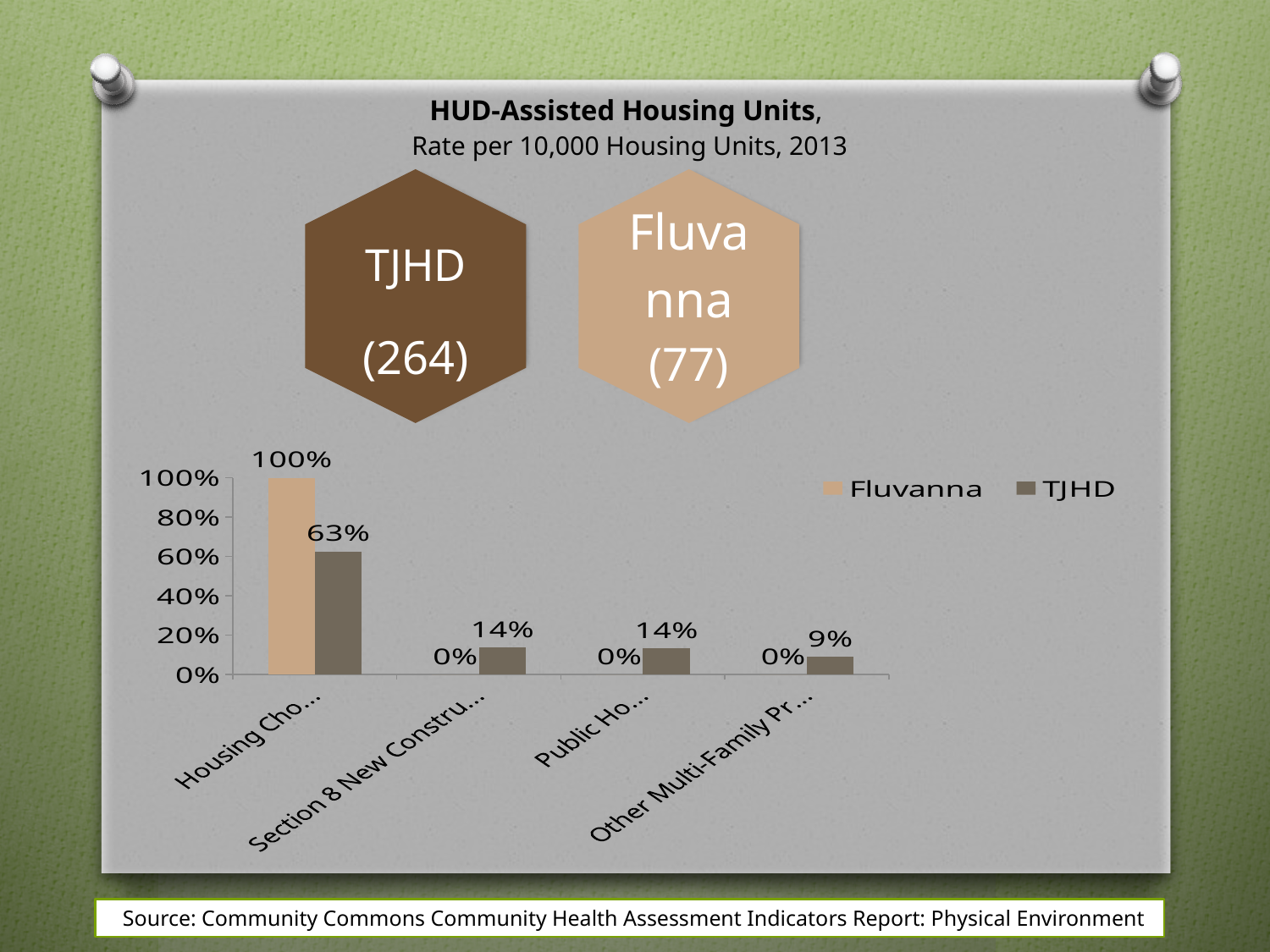
What is the TJHD value for the category labelled Section 8 New Constru...? 14% What is the Fluvanna value for the first category (Housing Cho...)? 100% In the first category (Housing Cho...), what is the difference between the Fluvanna value and the TJHD value? 37% Which category has the lowest TJHD value? Other Multi-Family Pr... (the last category) How many categories are plotted along the x axis of the chart? 4 What is the TJHD value for the first category (Housing Cho...)? 63% How many series does the chart legend list? 2 Which category has the highest TJHD value? Housing Cho... (the first category) What kind of chart is shown on the slide? bar chart What is the TJHD value for the last category (Other Multi-Family Pr...)? 9% What is the Fluvanna value for the category labelled Public Ho...? 0% What are the two entries in the chart legend? Fluvanna and TJHD